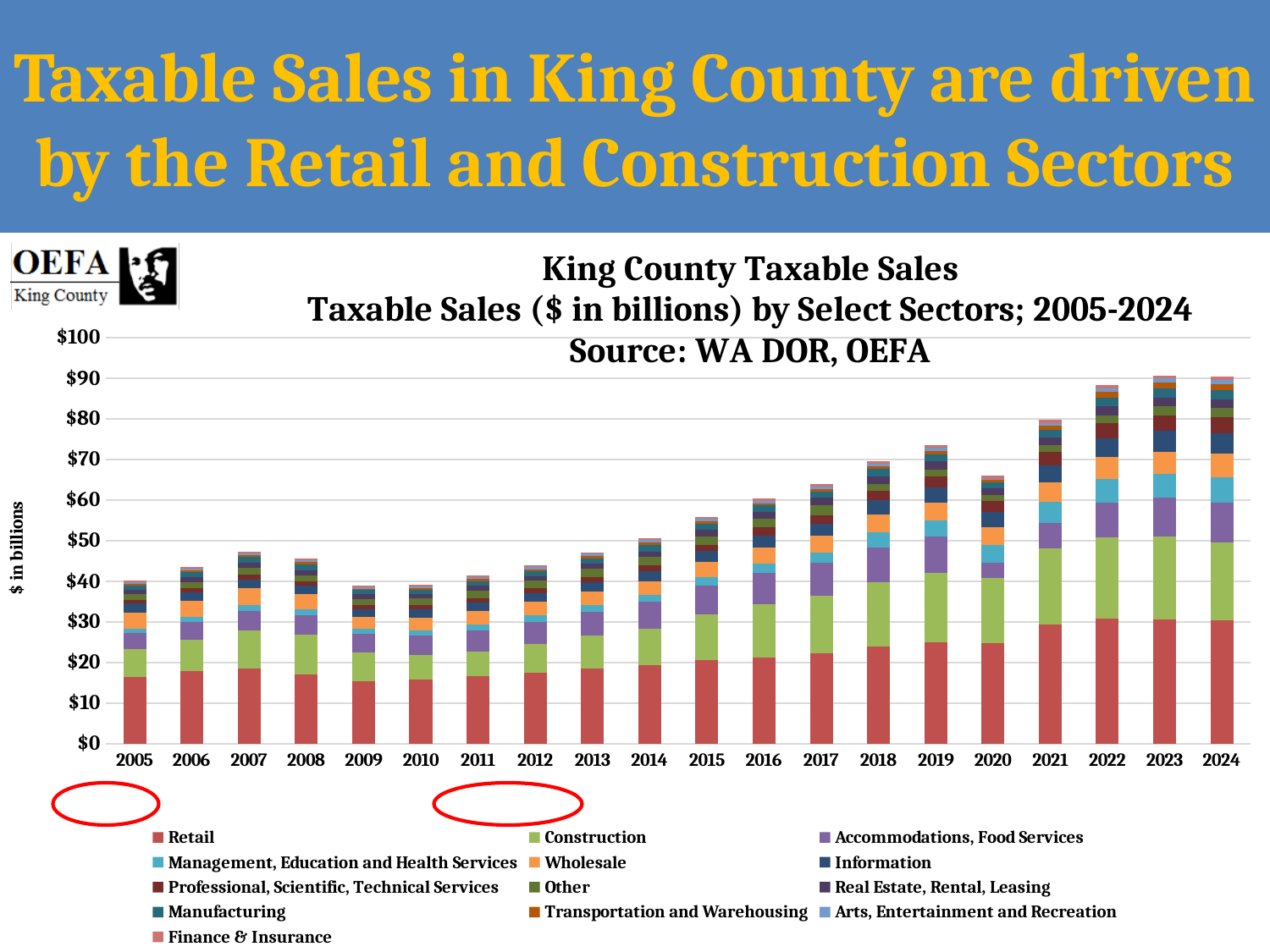
What is the source cited in the chart title? WA DOR, OEFA How many sectors does the legend of the King County Taxable Sales chart list? 13 Is the total taxable sales value for 2005 greater or less than $50 billion? less Is the total taxable sales value for 2020 greater or less than $60 billion? greater Overall, do total taxable sales rise or fall from 2005 to 2024? Rise Is the total taxable sales value for 2024 greater or less than $80 billion? greater Which year has the larger total taxable sales, 2008 or 2009? 2008 Which year has the larger total taxable sales, 2005 or 2024? 2024 How many years are shown along the x axis of the King County Taxable Sales chart? 20 What kind of chart is shown on the slide? Stacked bar chart